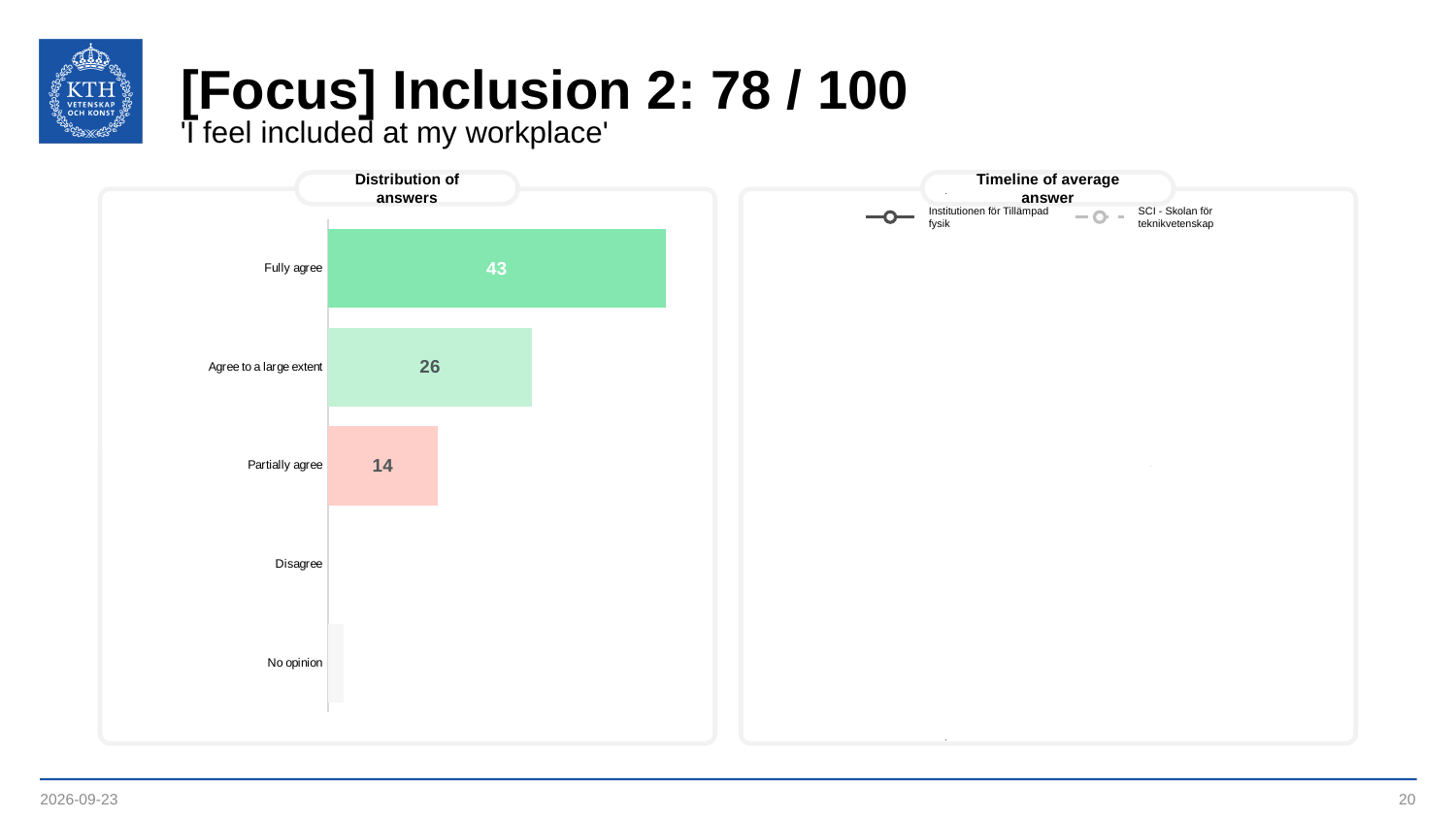
How many series does the legend of the 'Timeline of average answer' chart list? 2 In the 'Distribution of answers' chart, what is the value for 'Partially agree'? 14 What kind of chart is the 'Distribution of answers' chart? Bar chart How many categories are shown in the 'Distribution of answers' chart? 5 In the 'Distribution of answers' chart, what is the difference between the values for 'Agree to a large extent' and 'Partially agree'? 12 In the 'Distribution of answers' chart, what is the difference between the values for 'Fully agree' and 'Partially agree'? 29 In the 'Distribution of answers' chart, which is larger: the value for 'Agree to a large extent' or the value for 'Partially agree'? Agree to a large extent In the 'Distribution of answers' chart, what is the value for 'Fully agree'? 43 In the 'Distribution of answers' chart, which category has the highest value? Fully agree In the 'Distribution of answers' chart, what is the difference between the values for 'Fully agree' and 'Agree to a large extent'? 17 What is the title of the chart on the left side of the slide? Distribution of answers In the 'Distribution of answers' chart, what is the value for 'Agree to a large extent'? 26